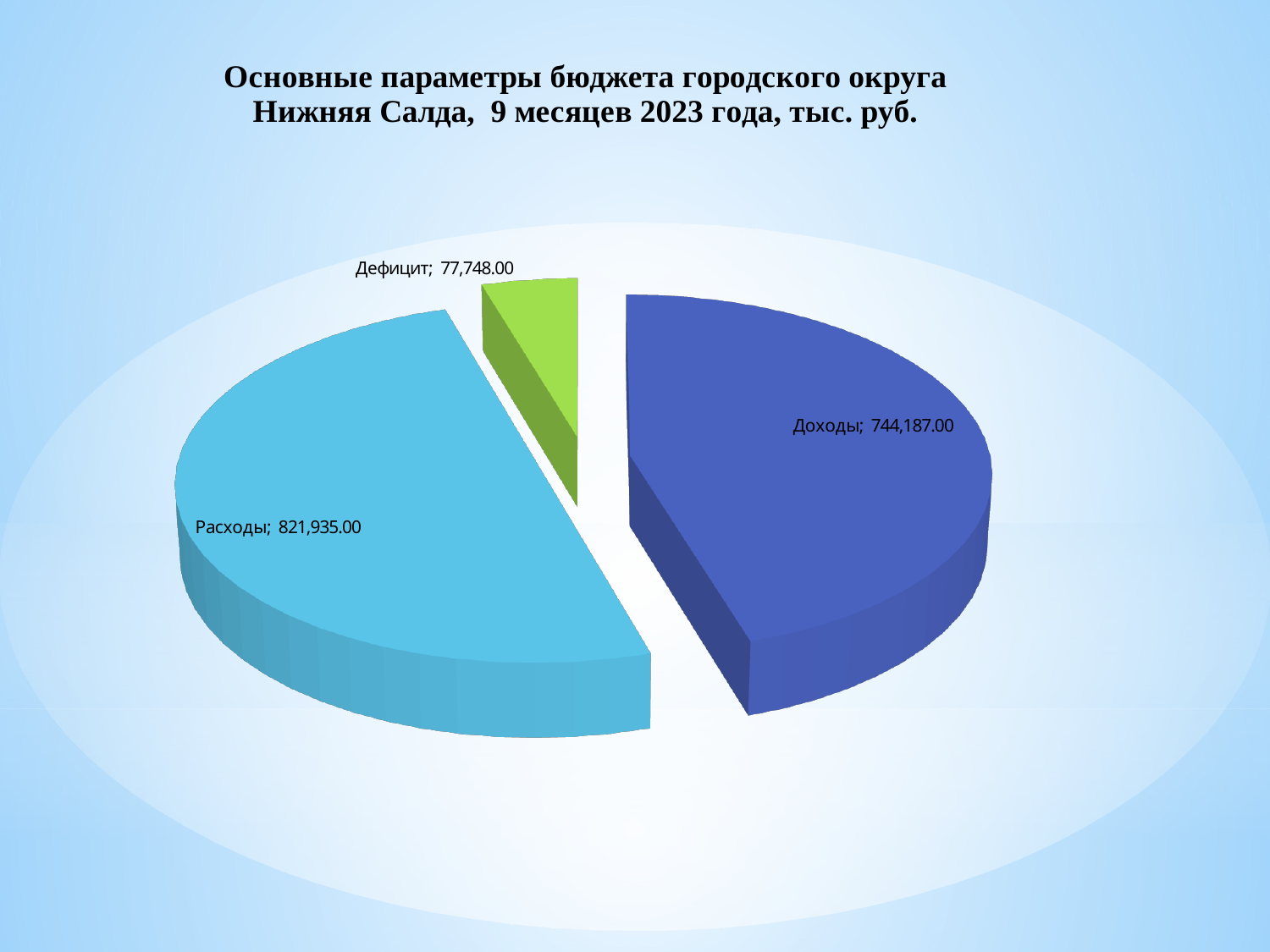
Which category has the smallest slice of the pie? Дефицит What is the value for Расходы? 821,935.00 How many slices does the pie chart have? 3 What type of chart is shown on the slide? Pie chart What is the value for Дефицит? 77,748.00 What is the title of the chart? Основные параметры бюджета городского округа Нижняя Салда, 9 месяцев 2023 года, тыс. руб. What is the difference between the values for Доходы and Дефицит? 666,439.00 What share of the pie does the Расходы slice represent? 50% Which category has the largest slice of the pie? Расходы Which is larger, the value for Доходы or the value for Расходы? Расходы What is the value for Доходы? 744,187.00 What is the difference between the values for Расходы and Доходы? 77,748.00